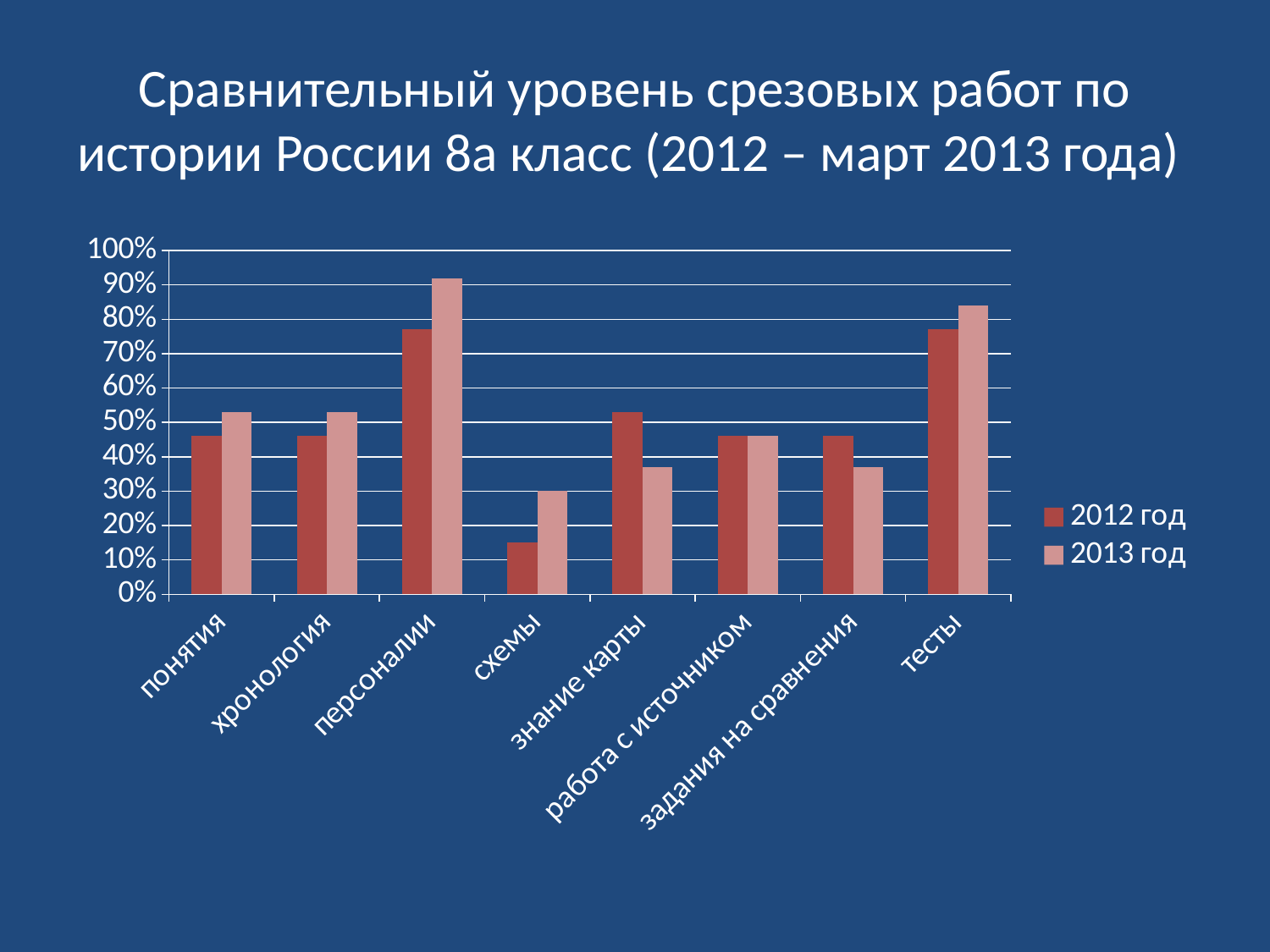
Is the 2012 год value for персоналии greater or less than 70%? greater Which category has the lowest value for the 2012 год series? схемы How many categories are shown on the x axis of the chart? 8 Which category has the highest value for the 2013 год series? персоналии How many series does the legend list? 2 Which category has the lowest value for the 2013 год series? схемы What are the two series listed in the legend? 2012 год and 2013 год For знание карты, which series has the larger value, 2012 год or 2013 год? 2012 год Is the 2013 год value for персоналии greater or less than 80%? greater Is the 2013 год value for схемы greater or less than 40%? less What kind of chart is shown on the slide? bar chart